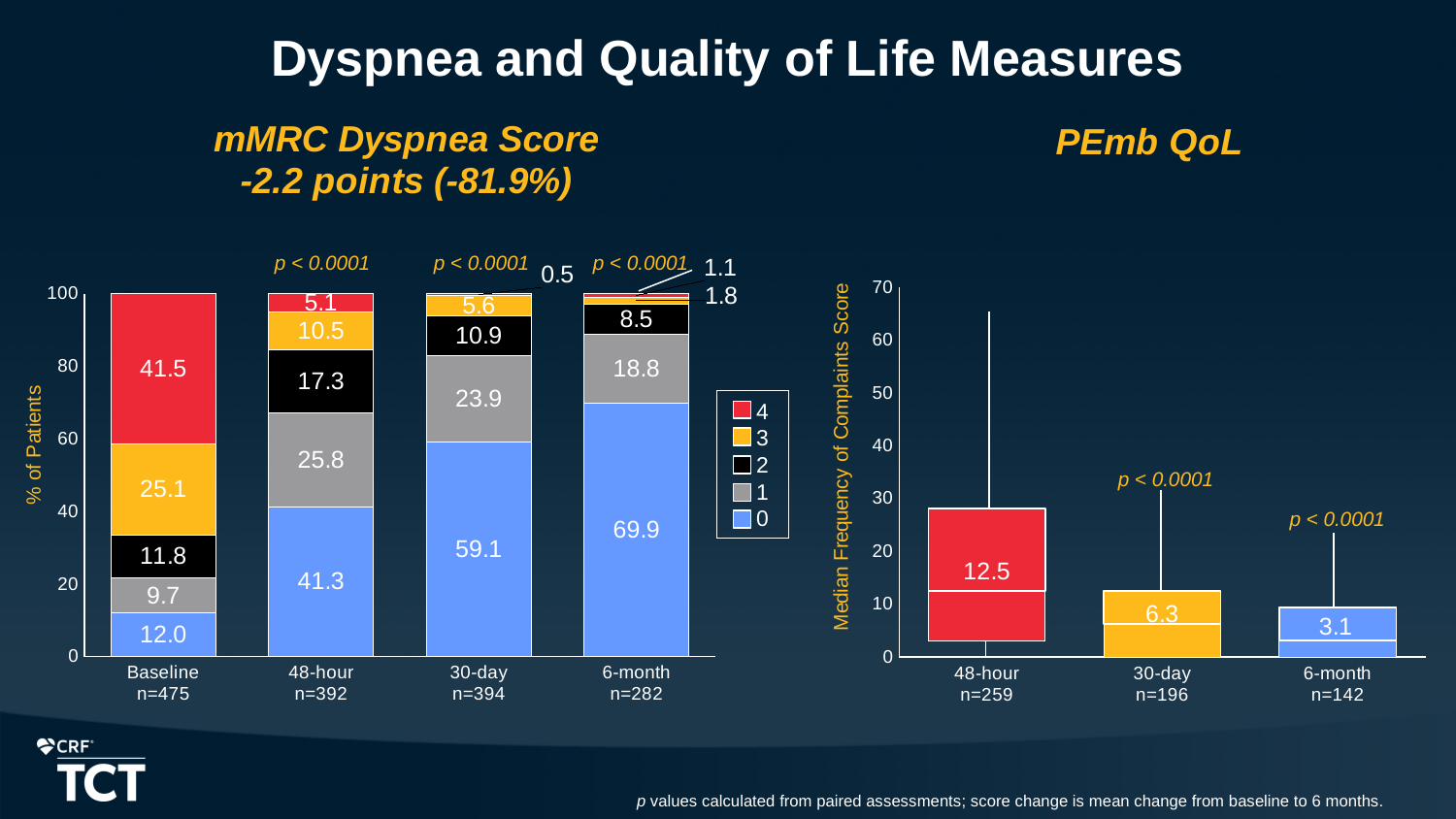
In the PEmb QoL chart, what is the median frequency of complaints score at 48-hour? 12.5 How many time points are shown on the x axis of the mMRC Dyspnea Score chart? 4 In the mMRC Dyspnea Score chart, what percentage of patients had a score of 0 at 6-month? 69.9 In the mMRC Dyspnea Score chart, what percentage of patients had a score of 1 at 30-day? 23.9 In the PEmb QoL chart, what is the sample size (n) at 30-day? n=196 In the PEmb QoL chart, do the median values rise or fall from 48-hour to 6-month? Fall In the mMRC Dyspnea Score chart, is the score 1 percentage larger at 48-hour or at 30-day? 48-hour In the mMRC Dyspnea Score chart, what percentage of patients had a score of 4 at Baseline? 41.5 What kind of chart is the PEmb QoL chart? Box plot In the mMRC Dyspnea Score chart, at which time point is the percentage of patients with a score of 0 highest? 6-month In the mMRC Dyspnea Score chart, what is the difference between the score 0 percentage at 6-month and at Baseline? 57.9 How many entries does the legend of the mMRC Dyspnea Score chart list? 5